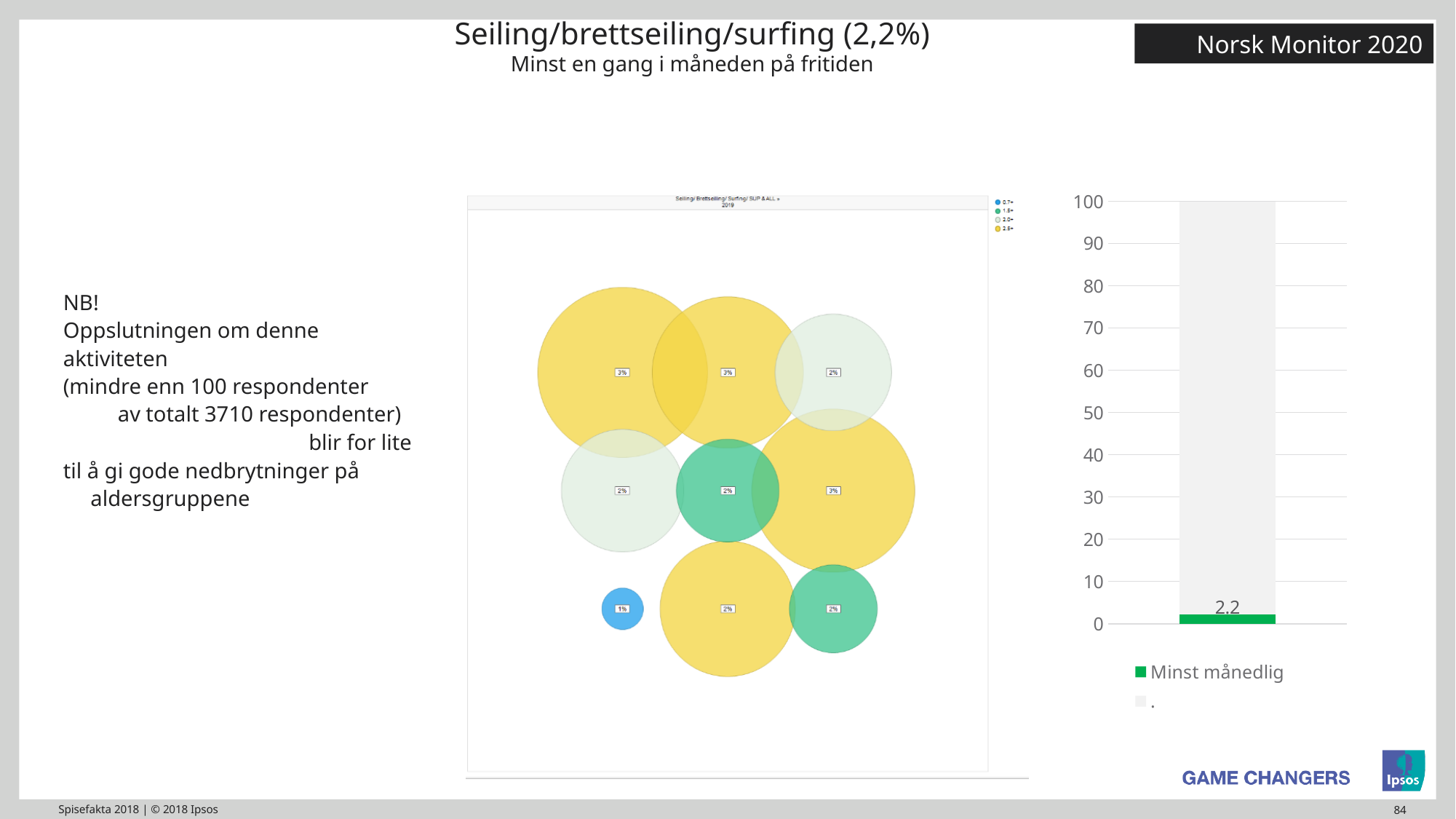
In the bubble chart in the centre of the slide, what colour is the bubble labelled 1%? blue On the bar chart on the right, what value is printed on the green 'Minst månedlig' segment? 2.2 In the bubble chart in the centre of the slide, how many bubbles are labelled 3%? 3 In the bubble chart in the centre of the slide, what is the lowest value printed on any bubble? 1% How many entries does the legend of the bar chart on the right list? 2 In the bubble chart in the centre of the slide, what is the highest value printed on any bubble? 3% On the bar chart on the right, is the value for 'Minst månedlig' greater or less than 10? less On the bar chart on the right, what is the highest value shown on the vertical axis? 100 What kind of chart is shown on the right side of the slide? bar chart On the bar chart on the right, what colour is the 'Minst månedlig' segment? green How many bars does the bar chart on the right contain? 1 How many bubbles are plotted in the bubble chart in the centre of the slide? 9